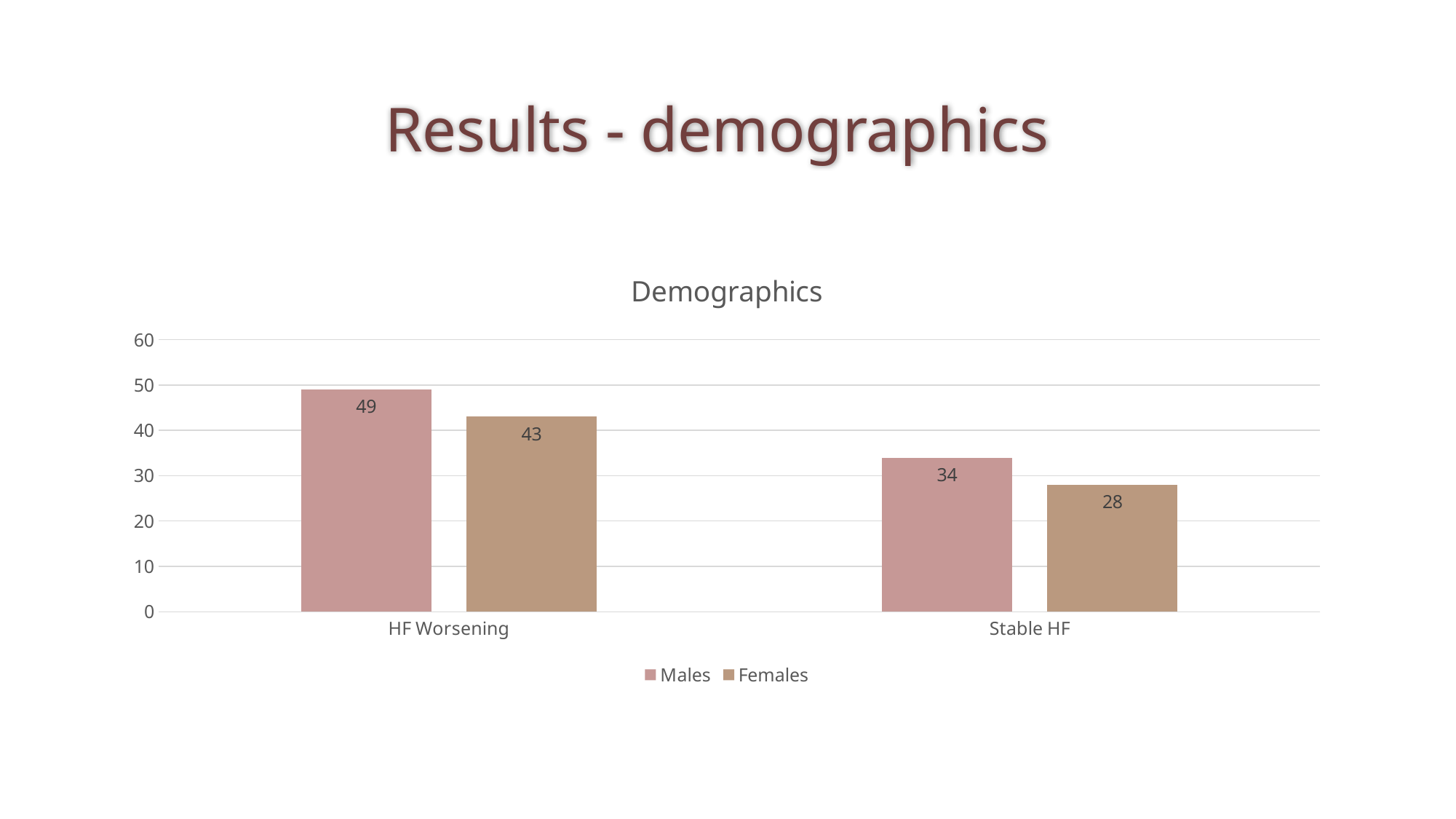
Which category has the lowest Females value? Stable HF Which category has the highest Males value? HF Worsening What is the value for Females in the Stable HF category? 28 What kind of chart is shown on the slide? Bar chart What is the value for Females in the HF Worsening category? 43 What is the value for Males in the HF Worsening category? 49 Which is larger in the Stable HF category, Males or Females? Males What is the value for Males in the Stable HF category? 34 How many series does the legend list? 2 How many categories are shown on the x axis? 2 What is the difference between the Males and Females values in the HF Worsening category? 6 What is the difference between the Males values for HF Worsening and Stable HF? 15